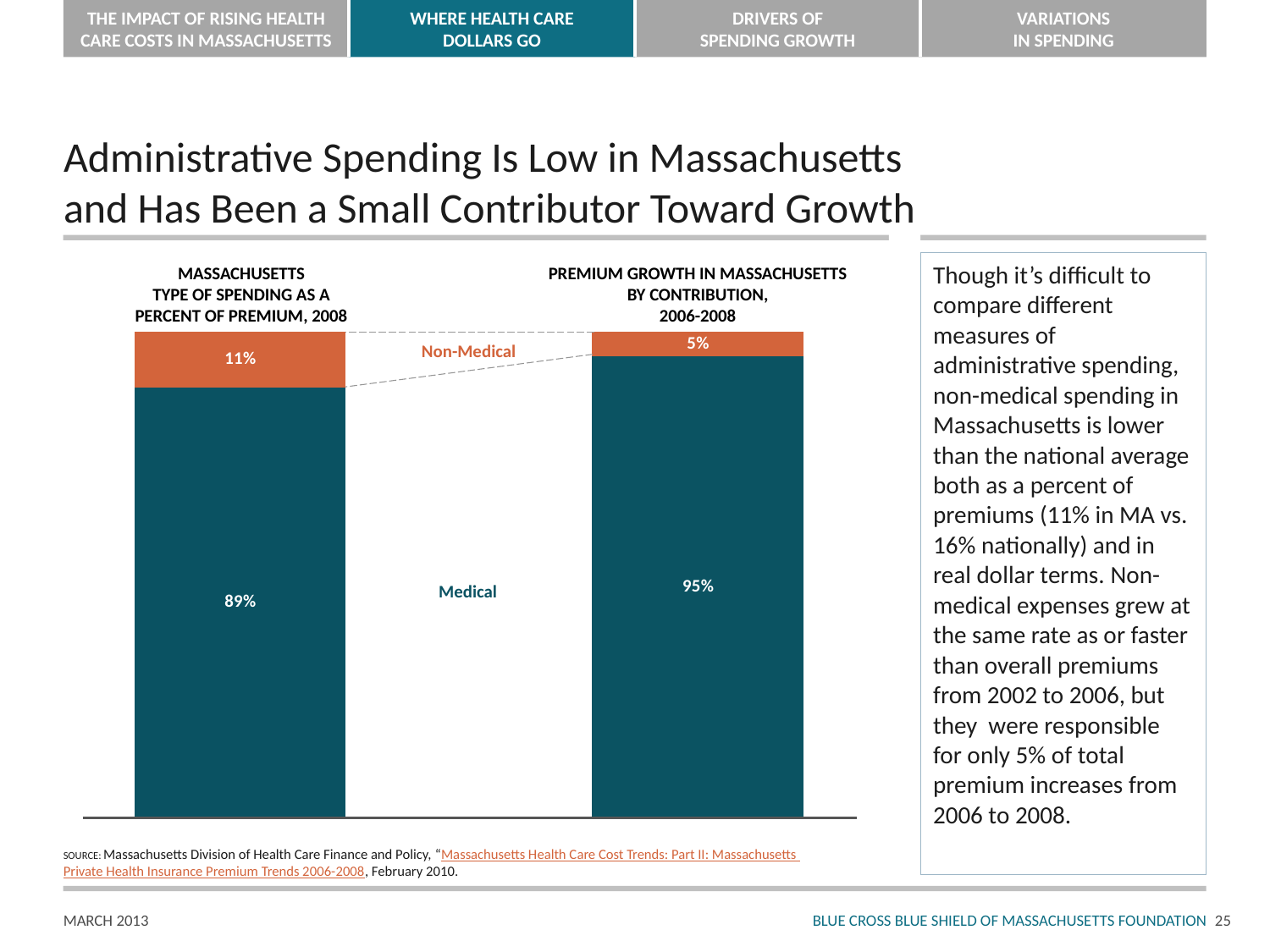
How many spending categories are shown in each stacked bar? 2 What is the difference between the Medical contribution to premium growth (2006-2008) and the Medical share of premium in 2008? 6 percentage points What type of chart is used on this slide? Stacked bar chart What share of premium growth in Massachusetts from 2006-2008 was contributed by Non-Medical spending? 5% What percent of premium was Non-Medical spending in Massachusetts in 2008? 11% Which segment is smallest in the Massachusetts Type of Spending as a Percent of Premium, 2008 bar? Non-Medical What is the total of the two segments in the Massachusetts Type of Spending as a Percent of Premium, 2008 bar? 100% What is the difference between the Non-Medical share of premium in 2008 and the Non-Medical contribution to premium growth in 2006-2008? 6 percentage points What share of premium growth in Massachusetts from 2006-2008 was contributed by Medical spending? 95% Which is larger: the Non-Medical share of premium in 2008 or the Non-Medical contribution to premium growth in 2006-2008? Non-Medical share of premium in 2008 Which segment is larger in the Premium Growth in Massachusetts by Contribution, 2006-2008 bar? Medical What percent of premium was Medical spending in Massachusetts in 2008? 89%